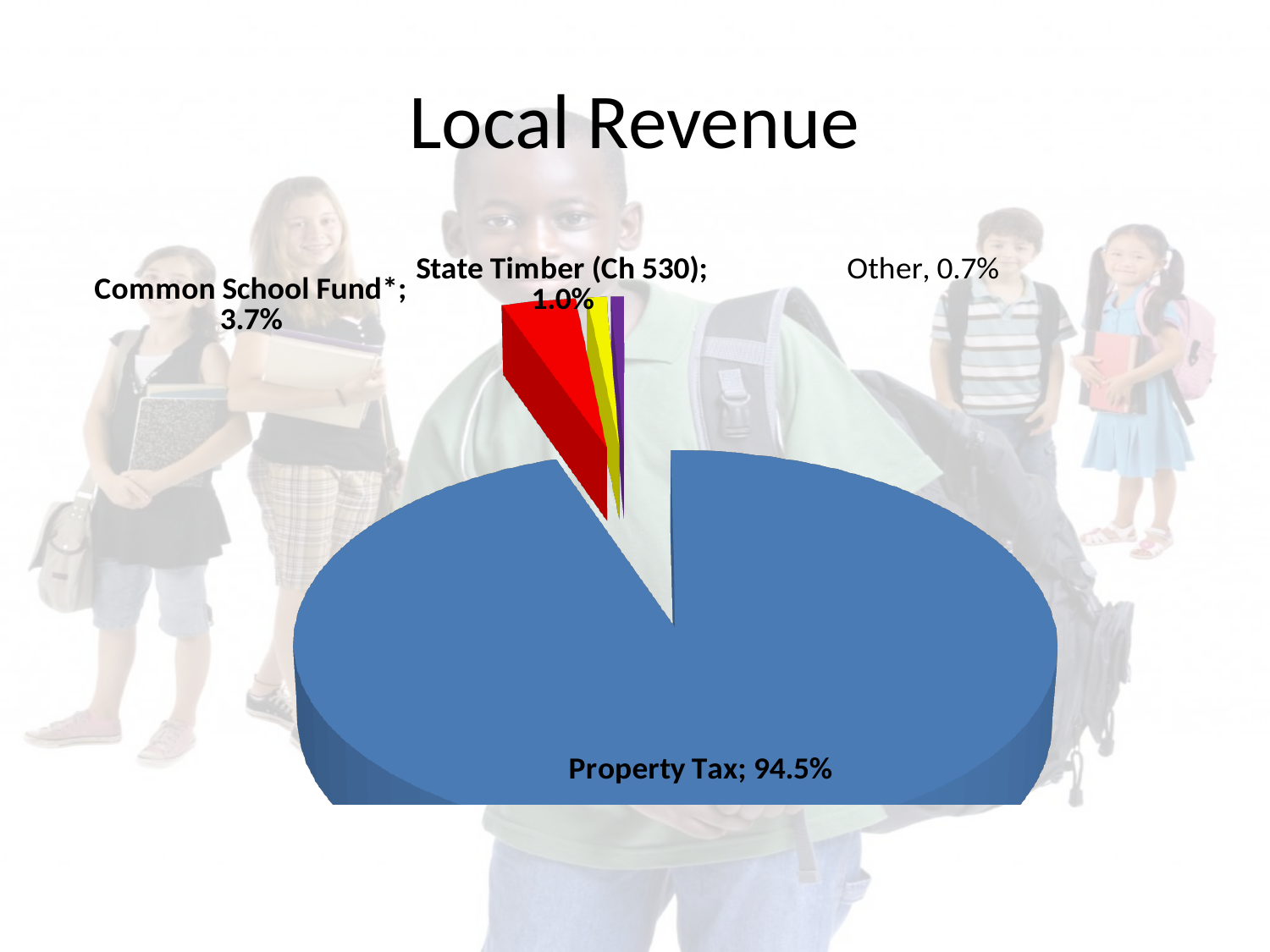
What share of local revenue comes from the Common School Fund*? 3.7% Which slice of the pie is the smallest? Other What colour is the Property Tax slice? blue Which is larger, the Common School Fund* share or the State Timber (Ch 530) share? Common School Fund* How many slices does the pie chart have? 4 What kind of chart is shown on the slide? pie chart What is the title of the chart? Local Revenue Which slice of the pie is the largest? Property Tax What share of local revenue is labelled Other? 0.7% What share of local revenue comes from State Timber (Ch 530)? 1.0% What is the difference in percentage points between the Property Tax share and the Common School Fund* share? 90.8 What share of local revenue comes from Property Tax? 94.5%